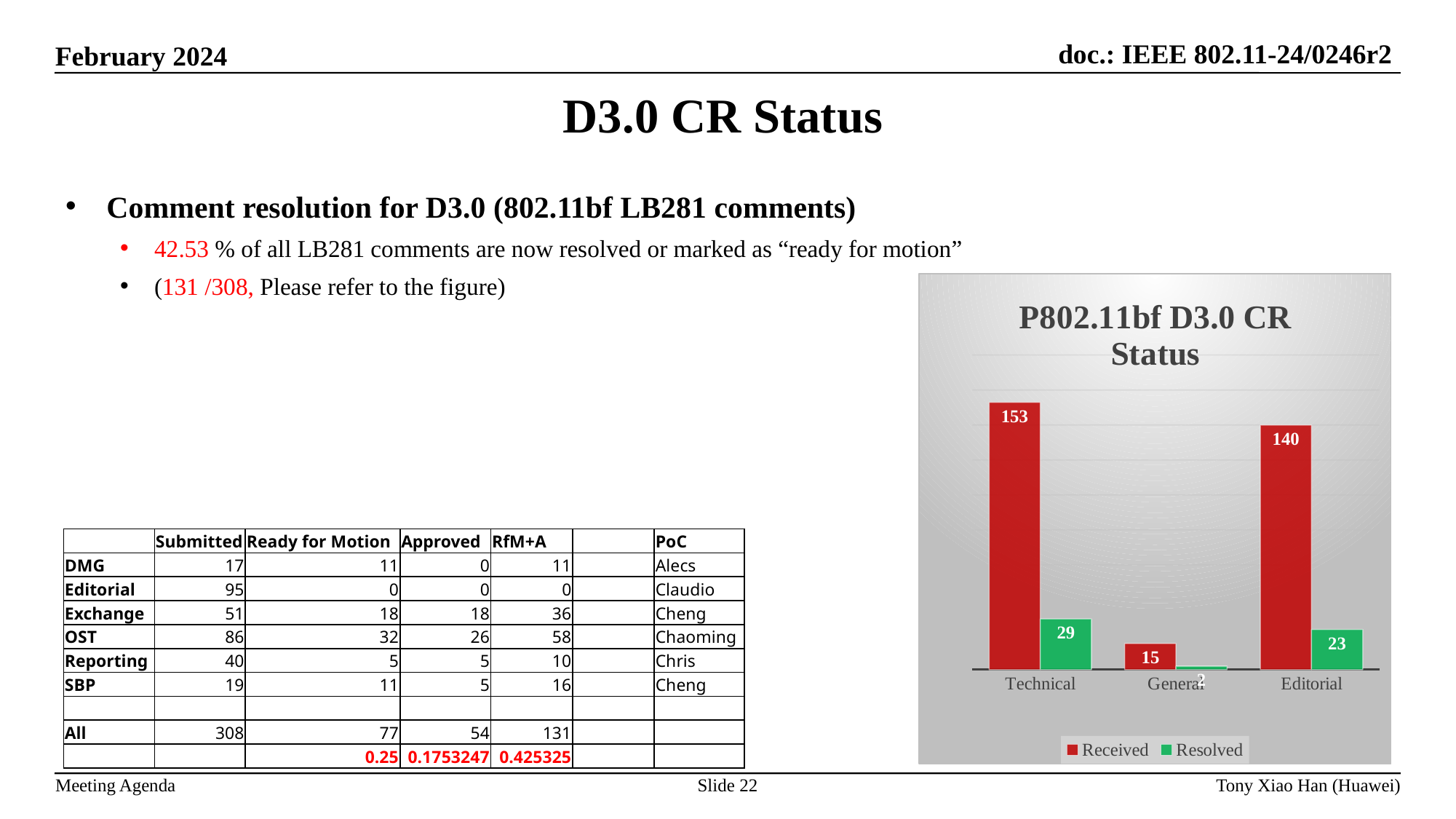
Which category has the lowest Received value in the chart? General Which is larger, the Resolved value for Technical or the Resolved value for Editorial? Technical What is the Received value for Editorial in the P802.11bf D3.0 CR Status chart? 140 What is the Received value for Technical in the P802.11bf D3.0 CR Status chart? 153 Which category has the highest Received value in the chart? Technical What type of chart is shown on the slide? bar chart What is the Resolved value for Editorial in the P802.11bf D3.0 CR Status chart? 23 What is the Received value for General in the P802.11bf D3.0 CR Status chart? 15 What is the Resolved value for Technical in the P802.11bf D3.0 CR Status chart? 29 How many categories are shown on the x axis of the chart? 3 What is the difference between the Received values for Technical and Editorial? 13 How many series does the chart legend list? 2